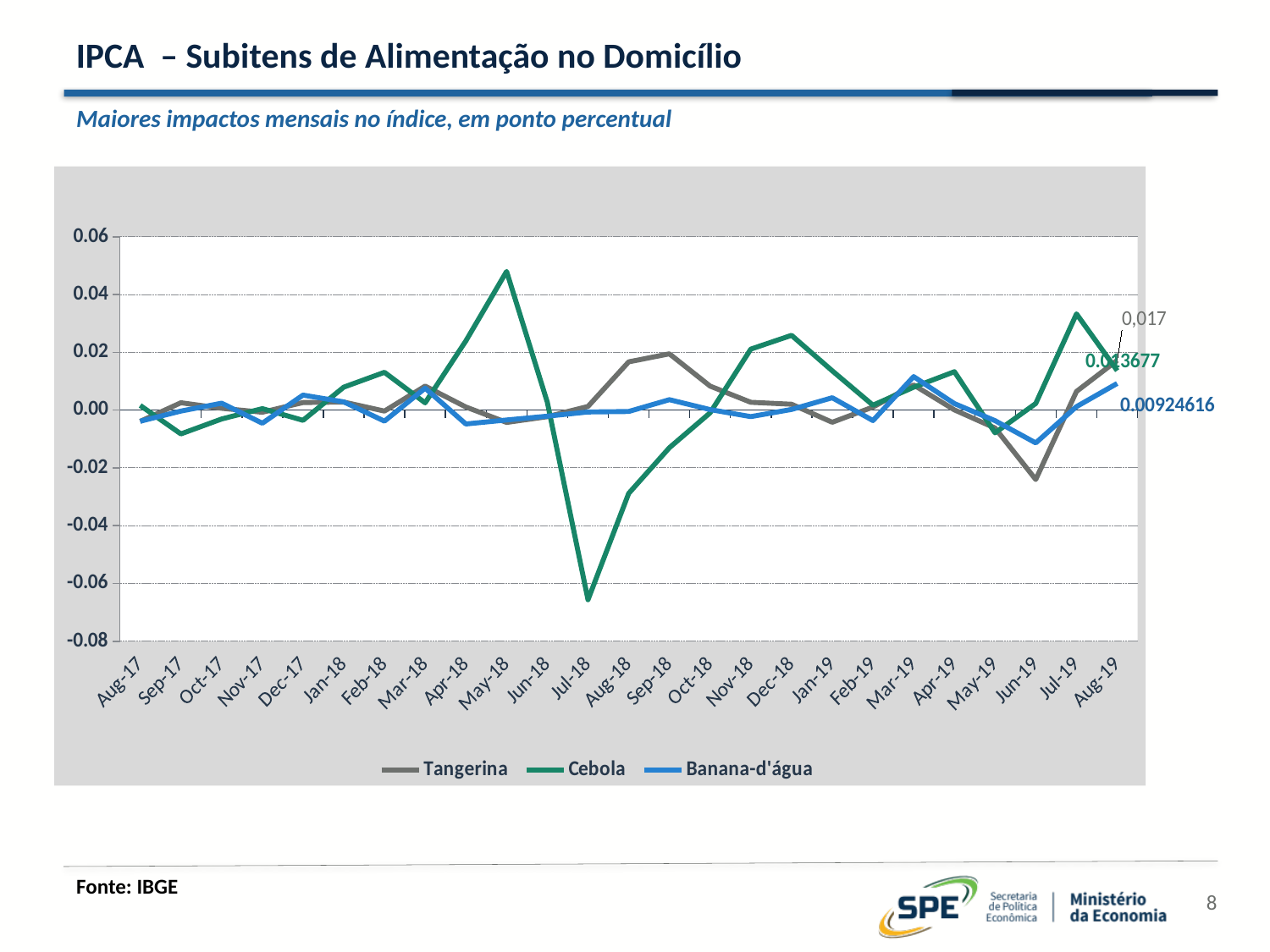
In Jul-18, which series has the larger value, Cebola or Tangerina? Tangerina What is the value for Banana-d'água in Aug-19? 0.00924616 What is the value for Tangerina in Aug-19? 0,017 What kind of chart is shown on the slide? line chart Is the value for Cebola in Jul-18 greater or less than -0.06? less Which series has the highest value in Aug-19? Tangerina In which month does Tangerina reach its lowest value? Jun-19 How many months are plotted along the x axis? 25 In which month does Cebola reach its highest value? May-18 How many series does the legend list? 3 In which month does Cebola reach its lowest value? Jul-18 Is the value for Cebola in May-18 greater or less than 0.04? greater